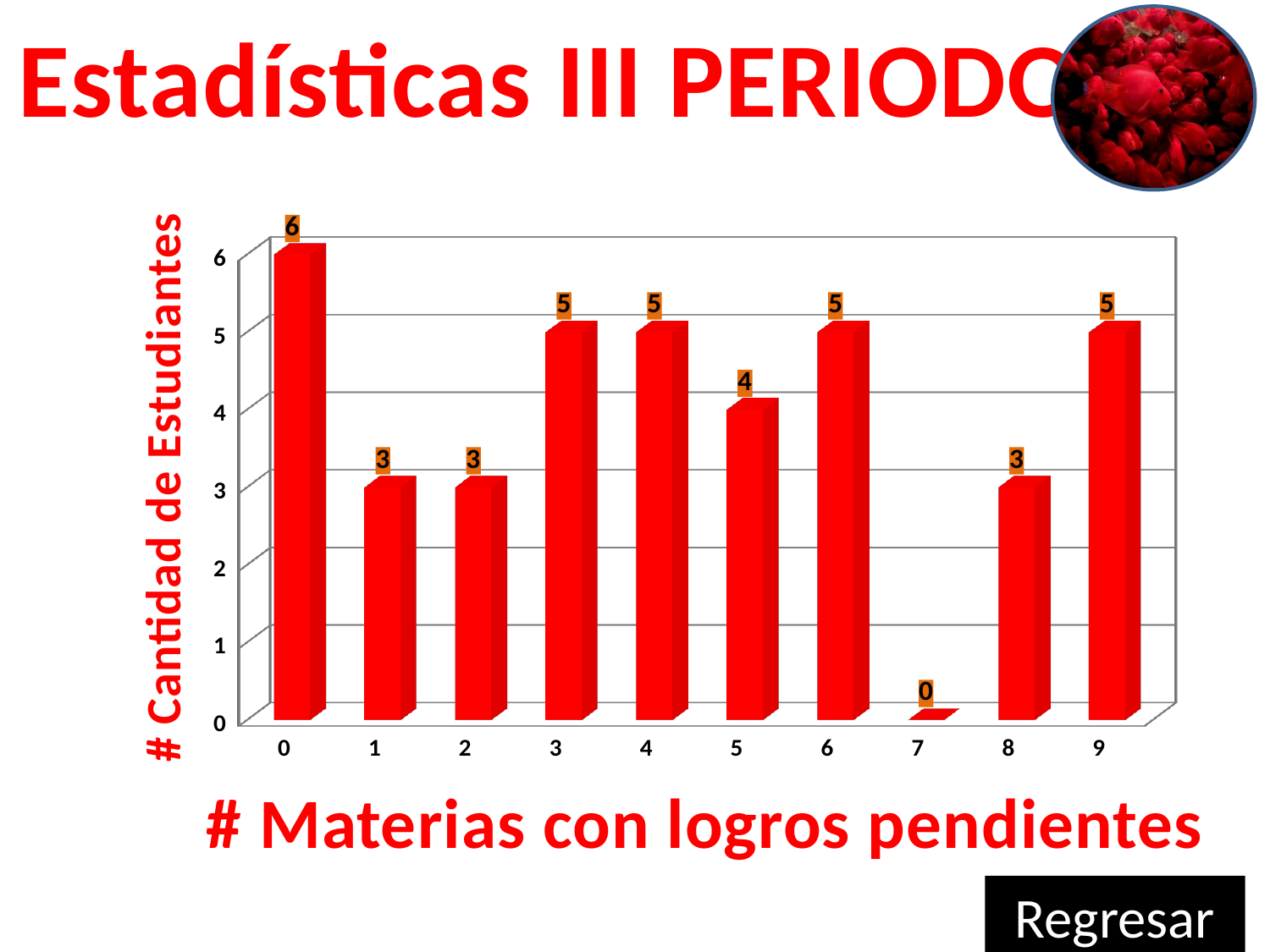
What kind of chart is shown on the slide? bar chart How many categories have a value of 5? 4 What is the label of the x axis? # Materias con logros pendientes Which category on the x axis has the lowest number of students? 7 Which is larger, the value for category 5 or the value for category 6? category 6 What is the difference between the value for category 0 and the value for category 1? 3 Which category on the x axis has the highest number of students? 0 What is the label of the y axis? # Cantidad de Estudiantes What is the value for category 7 on the x axis? 0 How many students have 0 subjects with pending achievements? 6 What is the value for category 5 on the x axis? 4 How many categories are shown on the x axis? 10